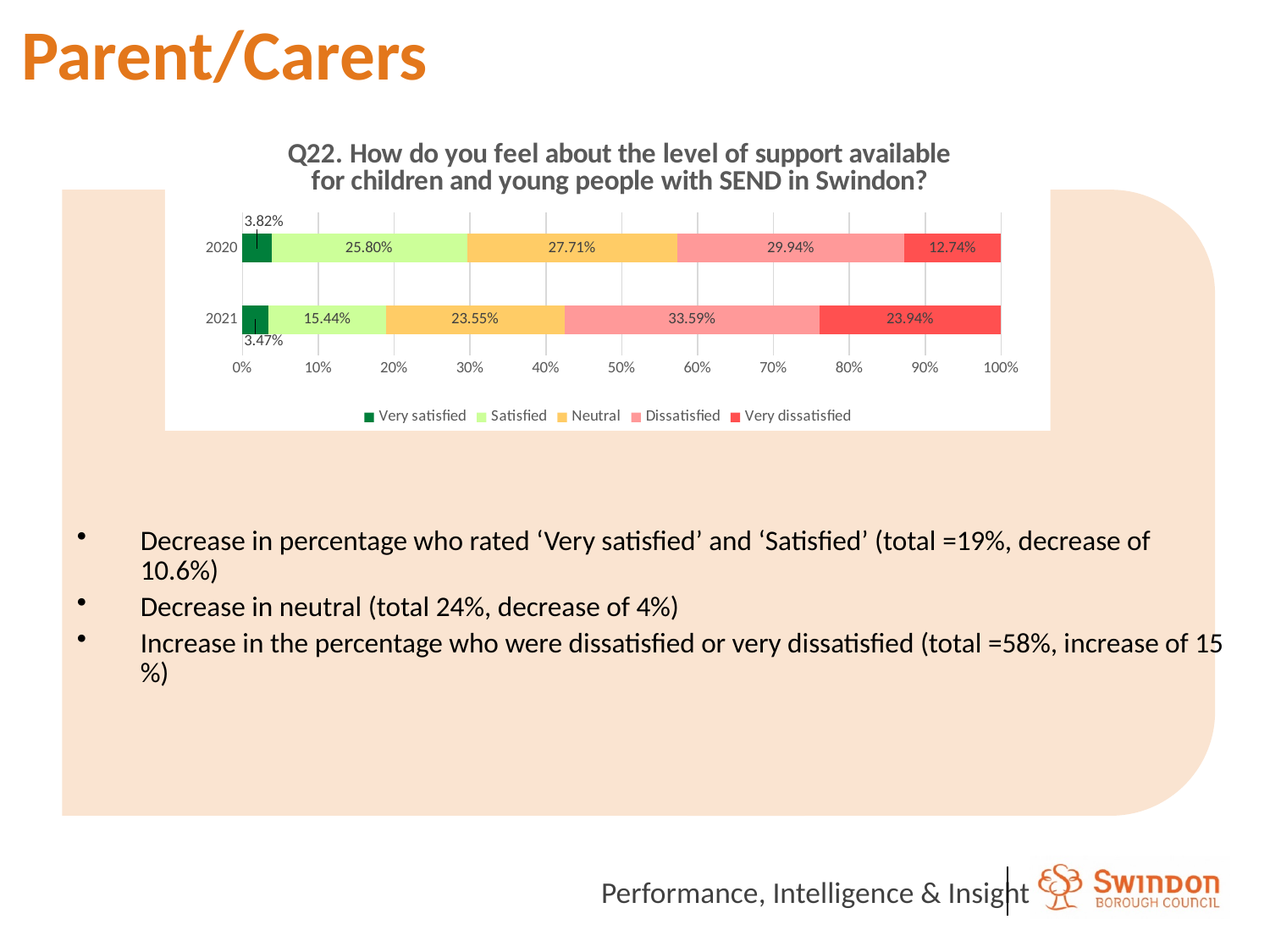
Which response category has the smallest share in the 2020 bar? Very satisfied Which response category has the largest share in the 2021 bar? Dissatisfied What is the value for 'Neutral' in 2020? 27.71% How many years are shown on the chart? 2 How many series does the legend list? 5 What is the value for 'Satisfied' in 2021? 15.44% Is the 'Dissatisfied' share larger in 2020 or in 2021? 2021 By how much did the 'Very dissatisfied' share increase from 2020 to 2021? 11.20% What is the value for 'Very satisfied' in 2020? 3.82% What is the value for 'Very dissatisfied' in 2021? 23.94% What kind of chart is shown on the slide? Stacked bar chart What is the value for 'Dissatisfied' in 2020? 29.94%